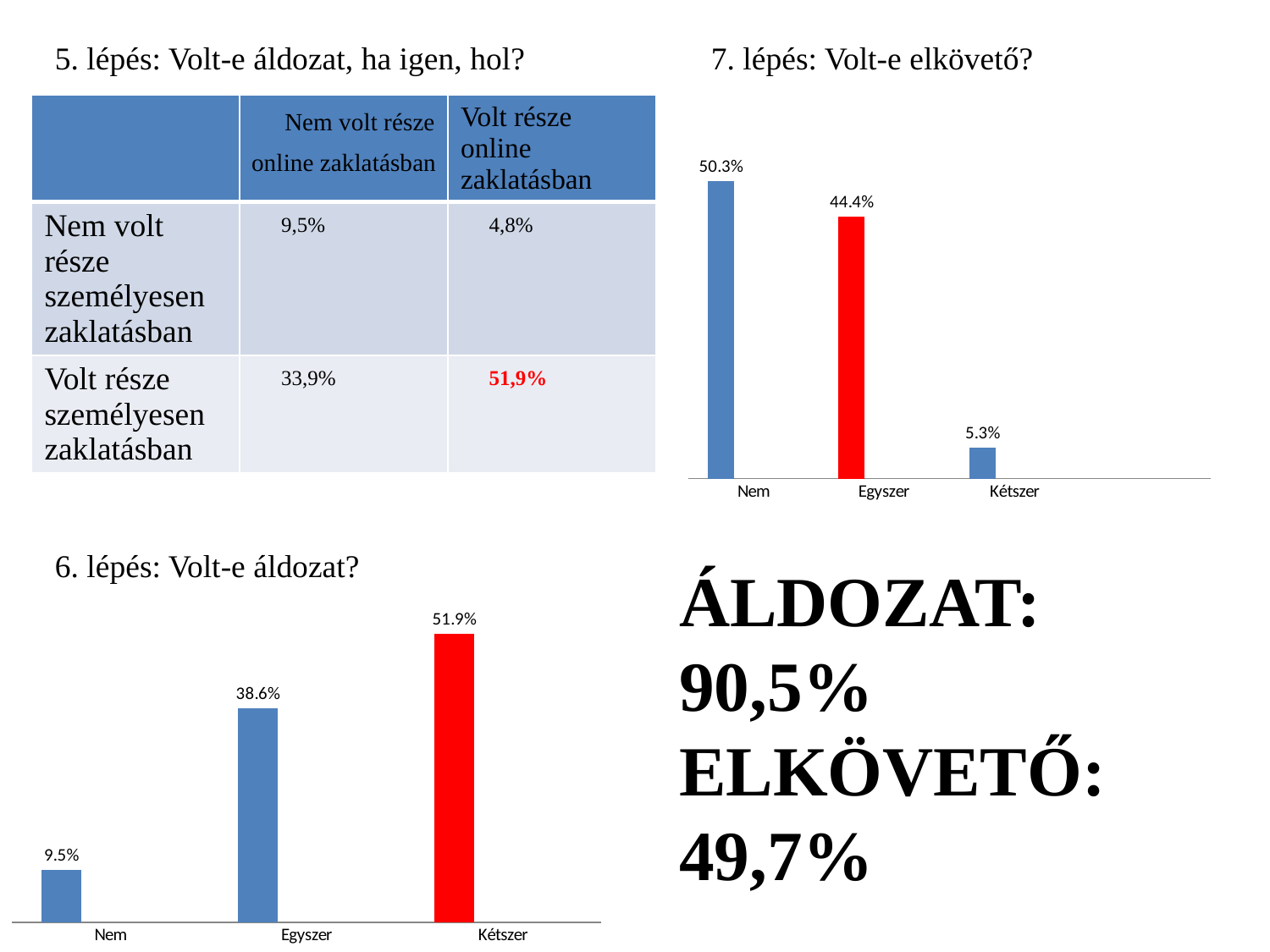
In the chart titled "6. lépés: Volt-e áldozat?", which category has the lowest value? Nem In the chart titled "7. lépés: Volt-e elkövető?", how many categories are shown on the x axis? 3 In the chart titled "6. lépés: Volt-e áldozat?", which is larger, the value for Egyszer or the value for Kétszer? Kétszer What kind of chart is the one titled "6. lépés: Volt-e áldozat?"? bar chart In the chart titled "7. lépés: Volt-e elkövető?", what is the difference between the values for Nem and Egyszer? 5.9% In the chart titled "6. lépés: Volt-e áldozat?", what is the value for Egyszer? 38.6% In the chart titled "7. lépés: Volt-e elkövető?", what is the value for Nem? 50.3% In the chart titled "6. lépés: Volt-e áldozat?", do the values rise or fall from Nem to Kétszer along the x axis? rise In the chart titled "7. lépés: Volt-e elkövető?", which bar is coloured red? Egyszer In the chart titled "7. lépés: Volt-e elkövető?", which category has the highest value? Nem In the chart titled "7. lépés: Volt-e elkövető?", what is the value for Kétszer? 5.3% In the chart titled "6. lépés: Volt-e áldozat?", what is the difference between the values for Kétszer and Nem? 42.4%